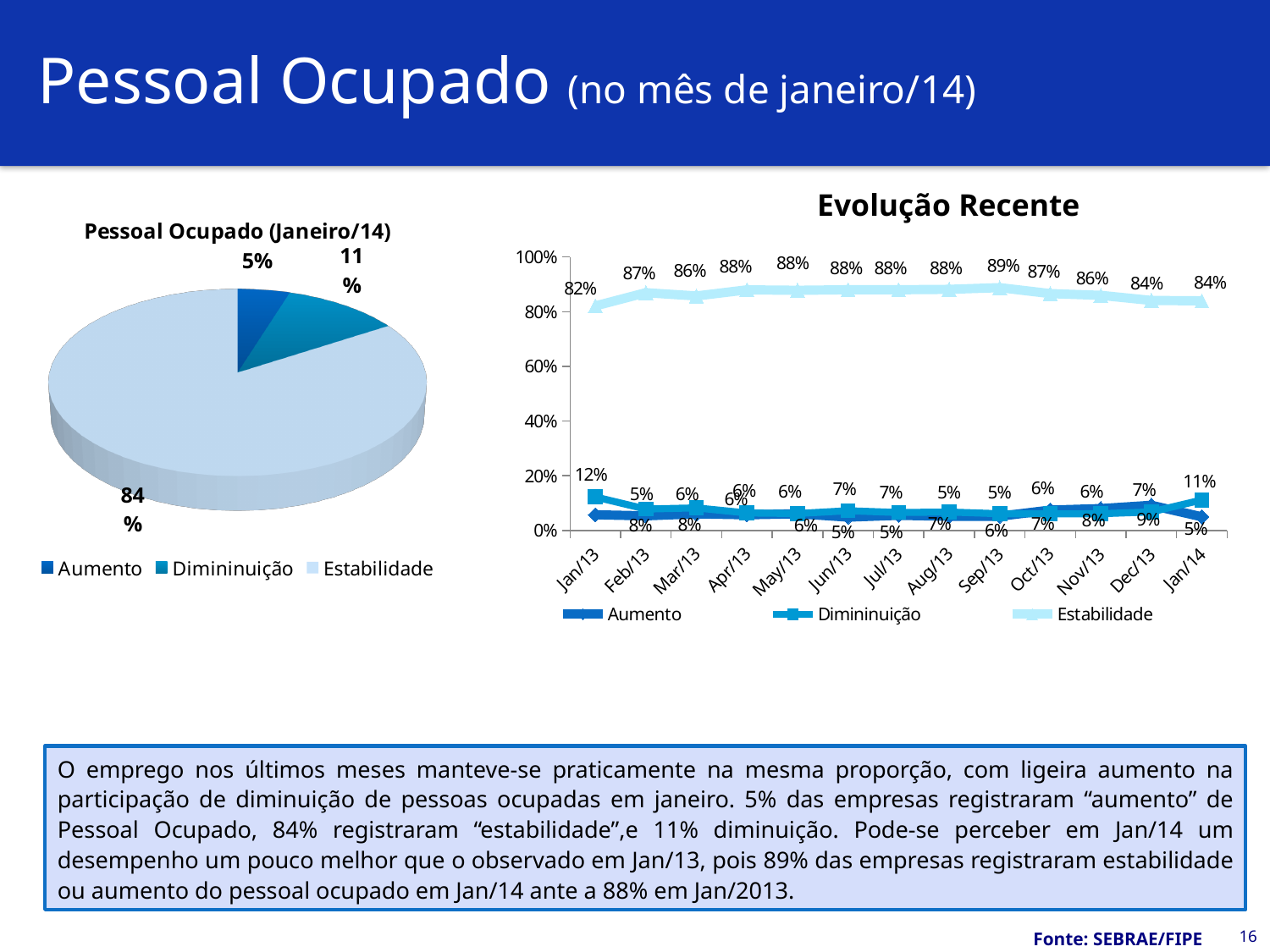
In the pie chart 'Pessoal Ocupado (Janeiro/14)', what share is Diminuição? 11% What kind of chart is 'Evolução Recente'? Line chart In the pie chart 'Pessoal Ocupado (Janeiro/14)', which category has the smallest slice? Aumento In the 'Evolução Recente' chart, how many months are plotted on the x axis? 13 In the 'Evolução Recente' chart, what is the value of Diminuição in Jan/14? 11% In the 'Evolução Recente' chart, what is the value of Estabilidade in Sep/13? 89% In the 'Evolução Recente' chart, in which month is Estabilidade lowest? Jan/13 In the 'Evolução Recente' chart, what is the difference between Estabilidade in Jan/13 and Jan/14? 2% In the pie chart 'Pessoal Ocupado (Janeiro/14)', what share is Estabilidade? 84% In the 'Evolução Recente' chart, what is the value of Aumento in Dec/13? 9% How many categories does the legend of the pie chart 'Pessoal Ocupado (Janeiro/14)' list? 3 In the 'Evolução Recente' chart, how many series does the legend list? 3